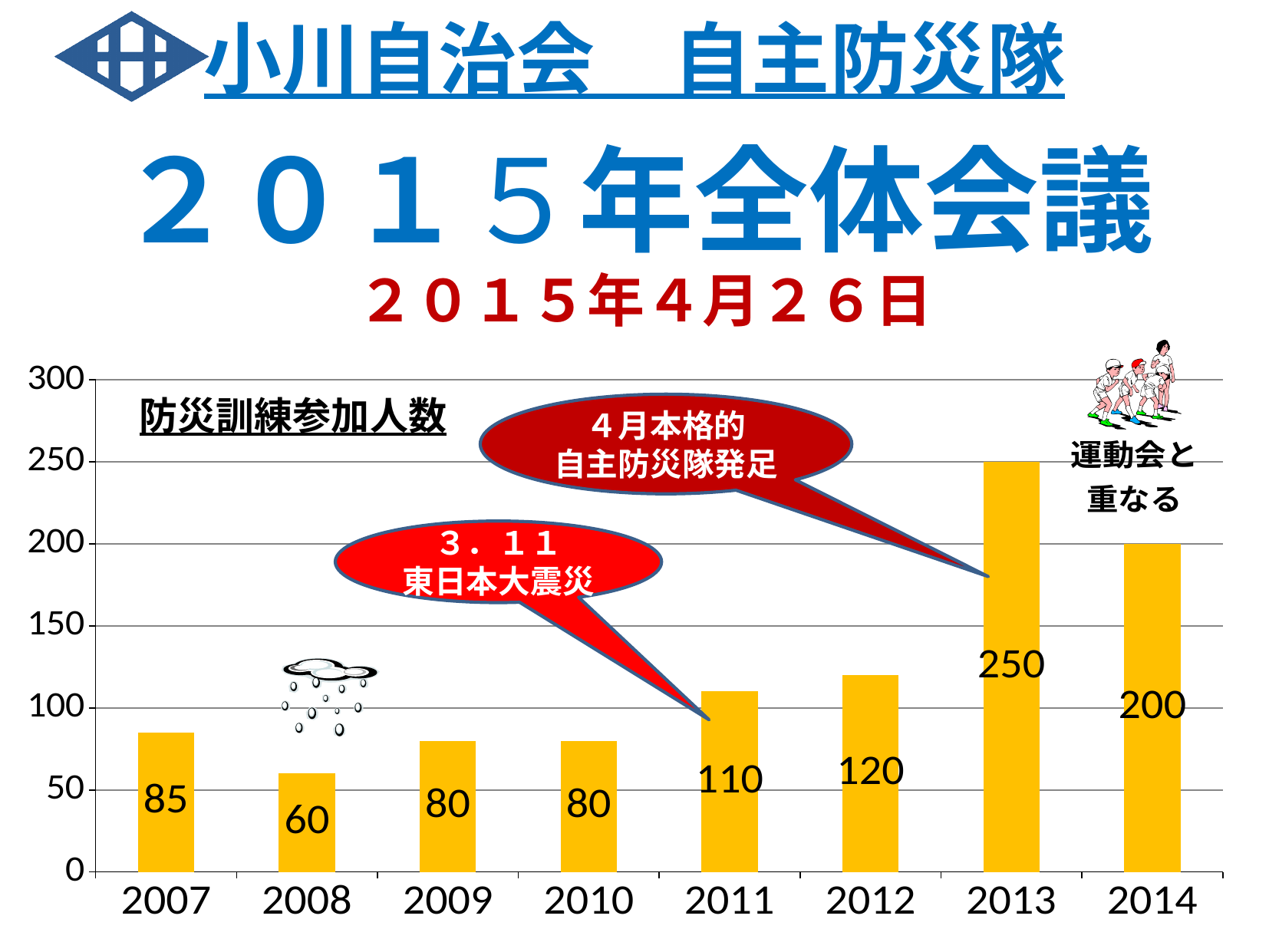
What is the value for 2007? 85 What is the title of the chart? 防災訓練参加人数 What is the difference between the values for 2012 and 2008? 60 What is the value for 2011? 110 Which is larger, the value for 2007 or the value for 2009? 2007 Which year has the highest value? 2013 What kind of chart is shown on the slide? bar chart How many years are shown on the x axis? 8 What is the difference between the values for 2013 and 2014? 50 Is the value for 2013 greater or less than 200? greater Which year has the lowest value? 2008 What is the value for 2014? 200